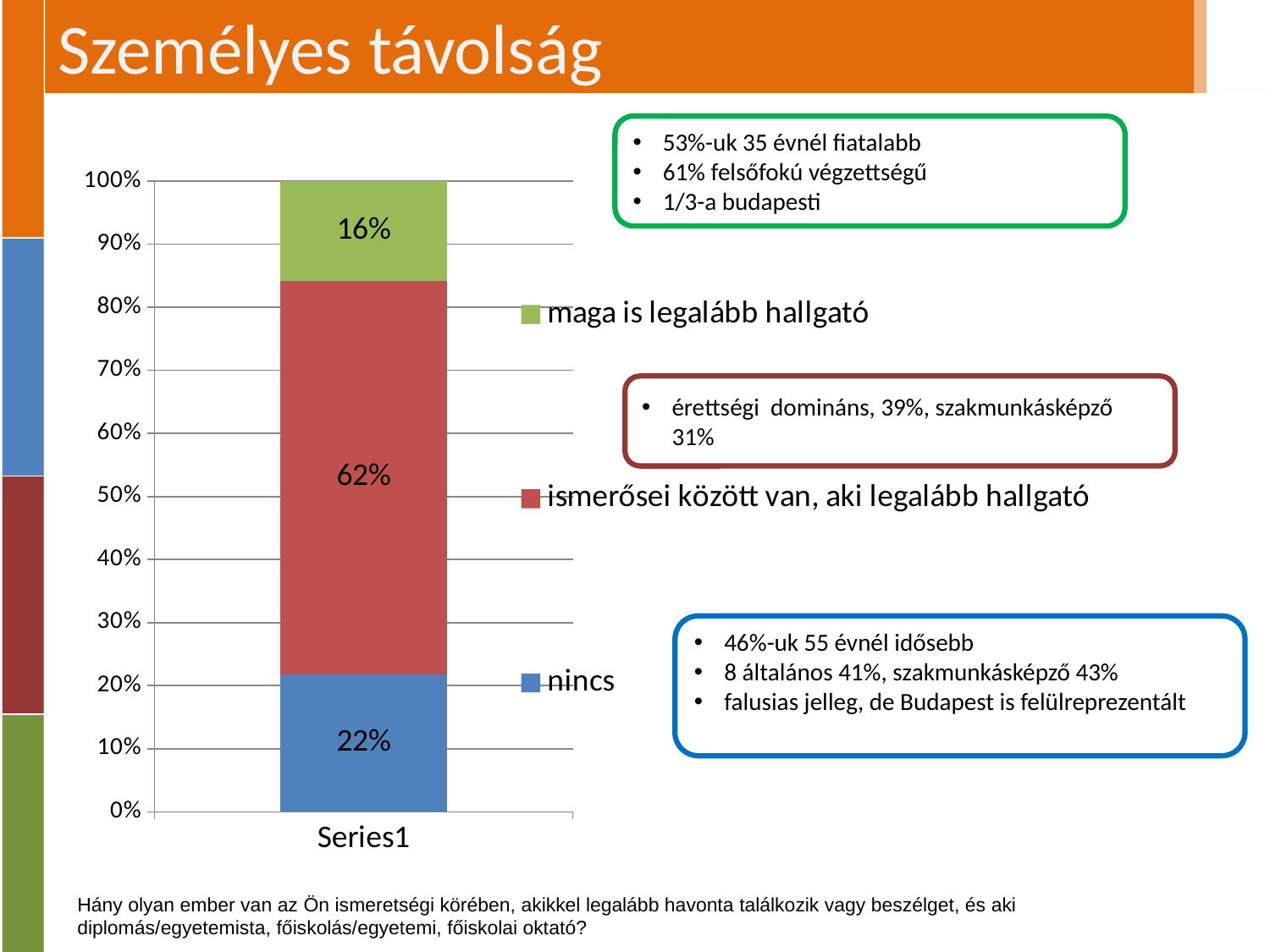
What is the value of the 'maga is legalább hallgató' segment? 16% Which segment of the stacked bar has the largest value? ismerősei között van, aki legalább hallgató What is the difference between the 'ismerősei között van, aki legalább hallgató' segment and the 'nincs' segment? 40% Which is larger, the 'nincs' segment or the 'maga is legalább hallgató' segment? nincs How many bars are plotted in the chart? 1 What colour is the 'nincs' segment in the chart? blue Which segment of the stacked bar has the smallest value? maga is legalább hallgató What is the value of the 'ismerősei között van, aki legalább hallgató' segment? 62% What kind of chart is shown on the slide? stacked bar chart What is the total of the stacked bar? 100% What is the value of the 'nincs' segment in the stacked bar? 22% How many series does the legend list? 3